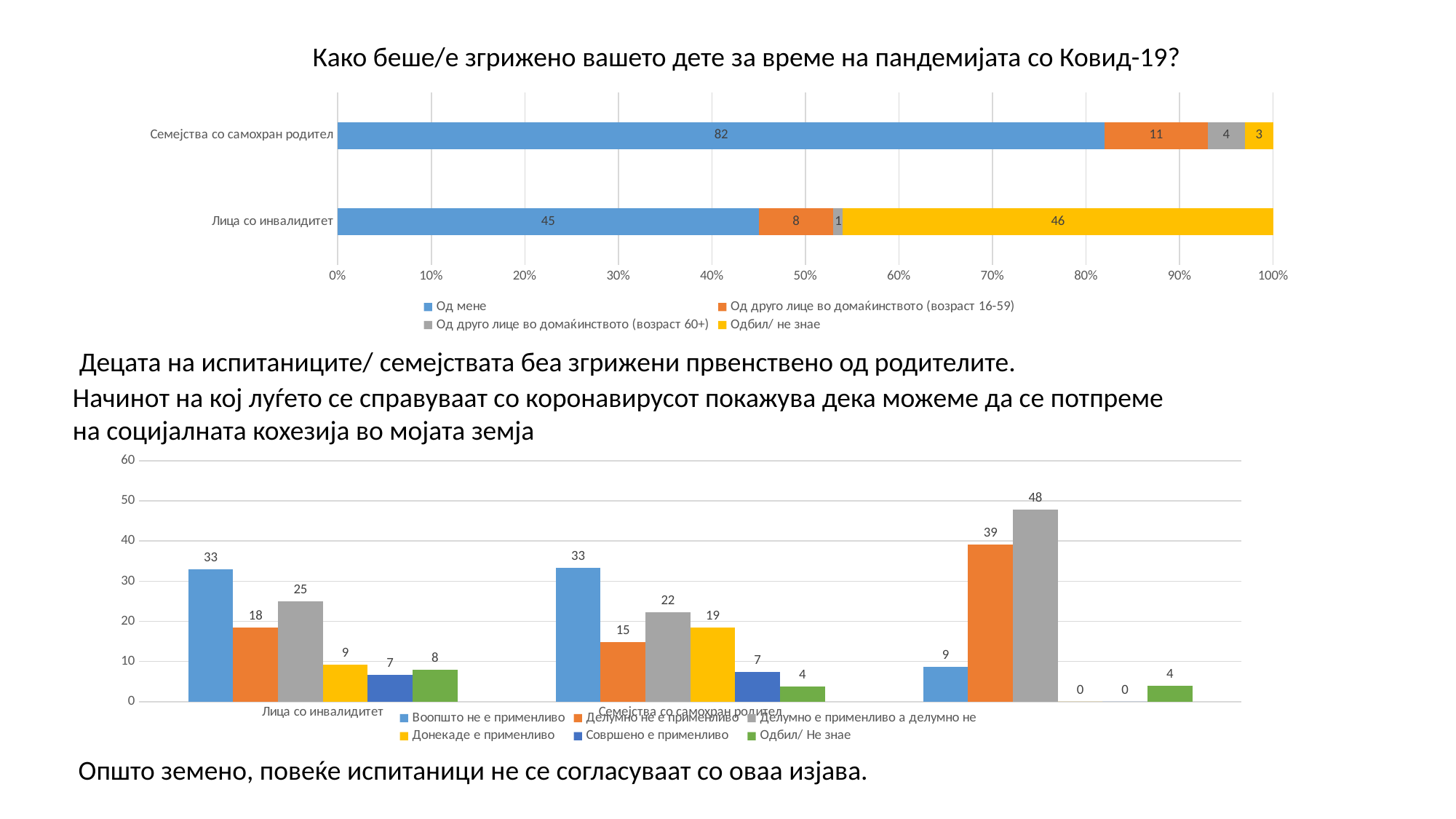
In the bottom chart, is the value of 'Делумно не е применливо' larger for 'Лица со инвалидитет' or for 'Семејства со самохран родител'? Лица со инвалидитет What kind of chart is the top chart on the slide? Stacked bar chart In the bottom chart, what is the value of 'Делумно е применливо а делумно не' for 'Лица со инвалидитет'? 25 In the bottom chart, how many series does the legend list? 6 In the bottom chart, which series has the lowest value for 'Семејства со самохран родител'? Одбил/ Не знае In the top chart, what is the difference between the 'Од мене' values for 'Семејства со самохран родител' and 'Лица со инвалидитет'? 37 In the top chart, how many series does the legend list? 4 In the top chart, what is the value of 'Одбил/ не знае' for 'Лица со инвалидитет'? 46 In the top chart 'Како беше/е згрижено вашето дете за време на пандемијата со Ковид-19?', what is the value of 'Од мене' for 'Семејства со самохран родител'? 82 In the top chart, what is the value of 'Од друго лице во домаќинството (возраст 16-59)' for 'Лица со инвалидитет'? 8 In the bottom chart, what is the value of 'Донекаде е применливо' for 'Семејства со самохран родител'? 19 In the bottom chart, which series has the highest value for 'Семејства со самохран родител'? Воопшто не е применливо